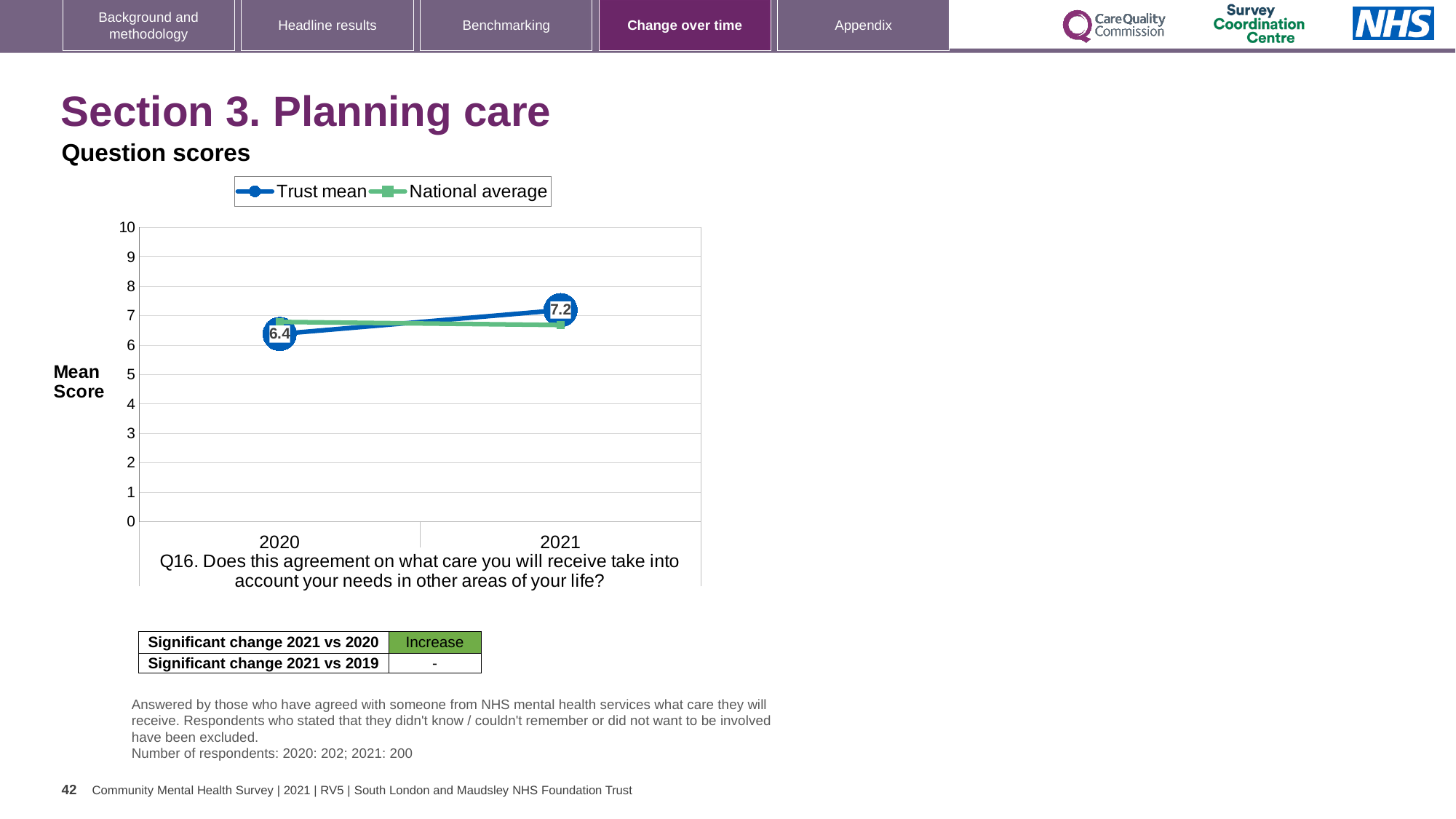
What is the Trust mean score for 2020? 6.4 By how much did the Trust mean score change from 2020 to 2021? 0.8 Is the National average value for 2020 greater or less than 5? greater What is the label on the y axis of the chart? Mean Score Is the National average value for 2021 greater or less than 8? less How many years are plotted on the x axis? 2 What kind of chart is shown on the slide? line chart What is the Trust mean score for 2021? 7.2 Does the Trust mean score rise or fall from 2020 to 2021? rise In 2021, which is higher, the Trust mean or the National average? Trust mean How many series does the legend list? 2 Which year has the higher Trust mean score, 2020 or 2021? 2021